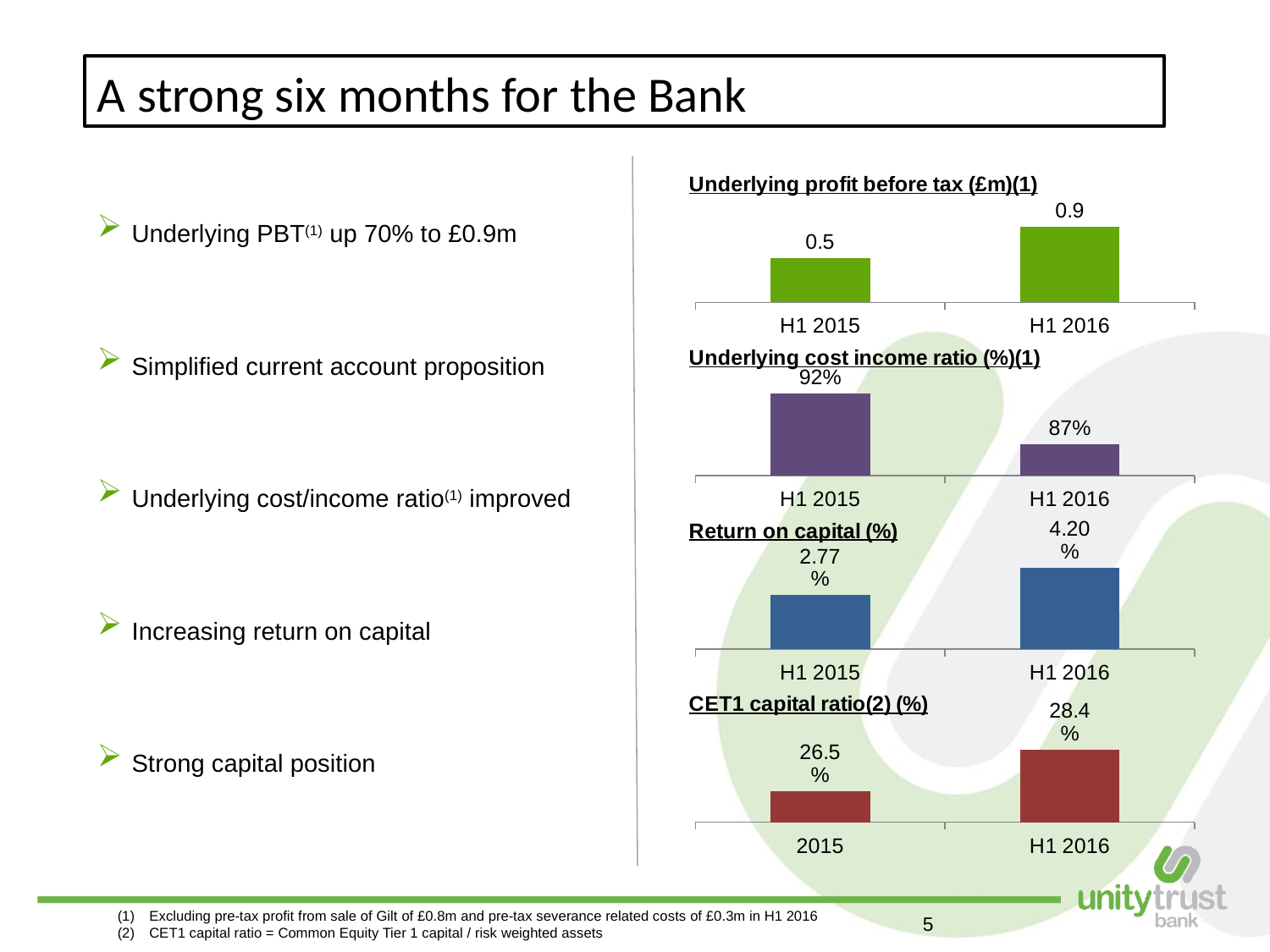
In the 'Return on capital (%)' chart, what is the value for H1 2016? 4.20% In the 'CET1 capital ratio (%)' chart, which period has the higher value? H1 2016 In the 'Return on capital (%)' chart, what is the value for H1 2015? 2.77% In the 'Underlying cost income ratio (%)' chart, what is the value for H1 2015? 92% In the 'Underlying profit before tax (£m)' chart, what is the value for H1 2016? 0.9 In the 'Underlying cost income ratio (%)' chart, what is the difference between the H1 2015 and H1 2016 values? 5% In the 'Underlying cost income ratio (%)' chart, which period has the lower value? H1 2016 In the 'Underlying profit before tax (£m)' chart, what is the difference between the H1 2016 and H1 2015 values? 0.4 In the 'CET1 capital ratio (%)' chart, what is the value for 2015? 26.5% In the 'CET1 capital ratio (%)' chart, do the values rise or fall from 2015 to H1 2016? rise What kind of chart is the 'Return on capital (%)' chart? bar chart In the 'Underlying profit before tax (£m)' chart, what is the value for H1 2015? 0.5